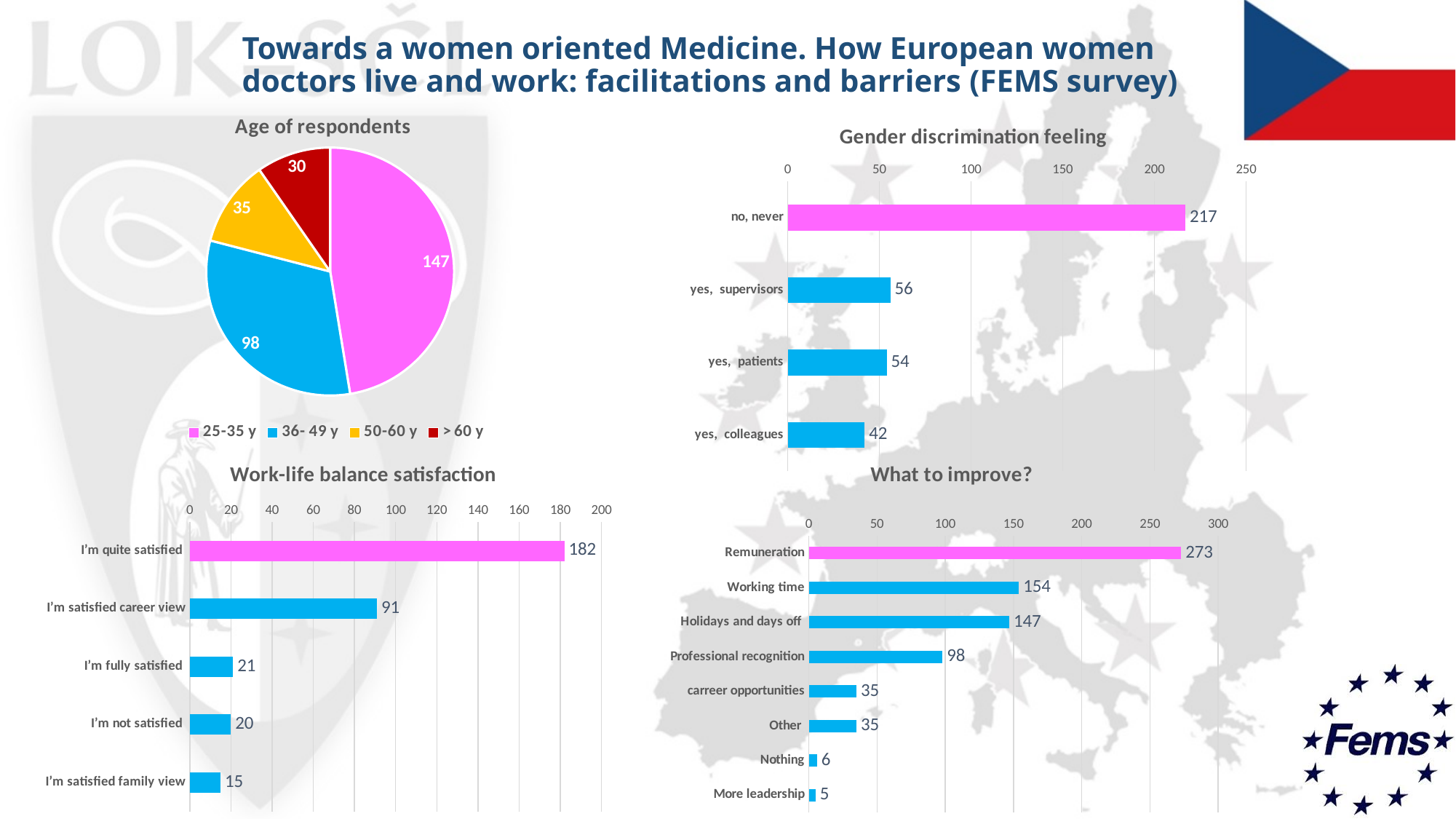
In the 'What to improve?' chart, which is larger: 'Working time' or 'Holidays and days off'? Working time In the 'Work-life balance satisfaction' chart, which category has the lowest value? I'm satisfied family view In the 'Age of respondents' pie chart, which age group has the smallest slice? > 60 y In the 'Gender discrimination feeling' chart, what is the difference between 'yes, supervisors' and 'yes, colleagues'? 14 In the 'Age of respondents' pie chart, what is the value for the 36- 49 y slice? 98 In the 'What to improve?' chart, what is the value for 'Professional recognition'? 98 In the 'Work-life balance satisfaction' chart, what is the value for 'I'm satisfied career view'? 91 In the 'What to improve?' chart, which category has the highest value? Remuneration What kind of chart is 'Gender discrimination feeling'? bar chart In the 'Gender discrimination feeling' chart, what is the value for 'no, never'? 217 How many age groups does the legend of the 'Age of respondents' pie chart list? 4 How many categories are shown in the 'Work-life balance satisfaction' chart? 5